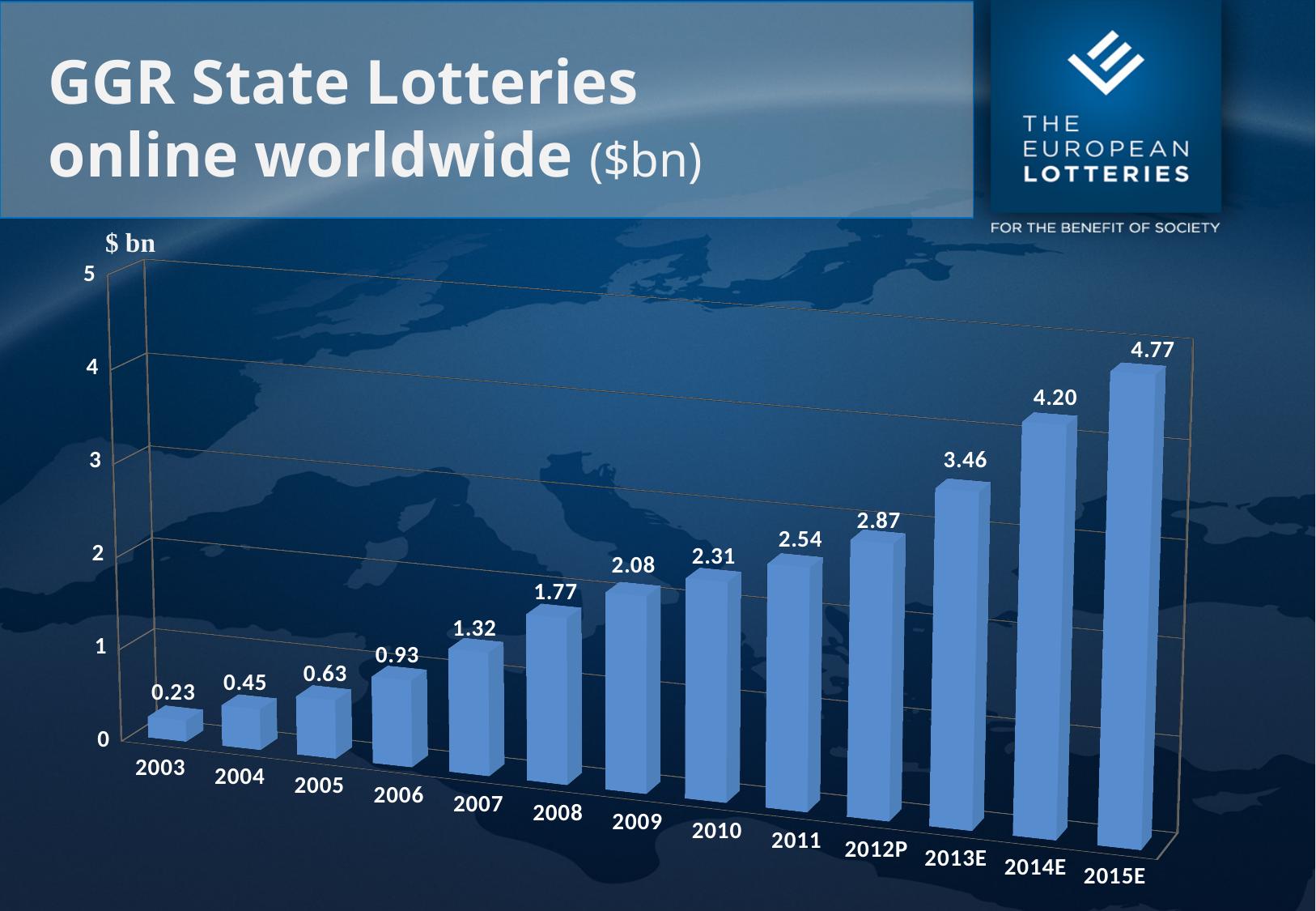
What is the difference between the values for 2015E and 2014E? 0.57 What is the difference between the values for 2008 and 2007? 0.45 What is the value for 2009? 2.08 What is the value for 2003? 0.23 Which year has the lowest value? 2003 What kind of chart is this? bar chart What is the value for 2015E? 4.77 Which year has the highest value? 2015E Which is larger, the value for 2011 or the value for 2012P? 2012P How many years are shown on the x axis? 13 Do the values rise or fall from 2003 to 2015E? rise What unit is shown on the y axis label? $ bn